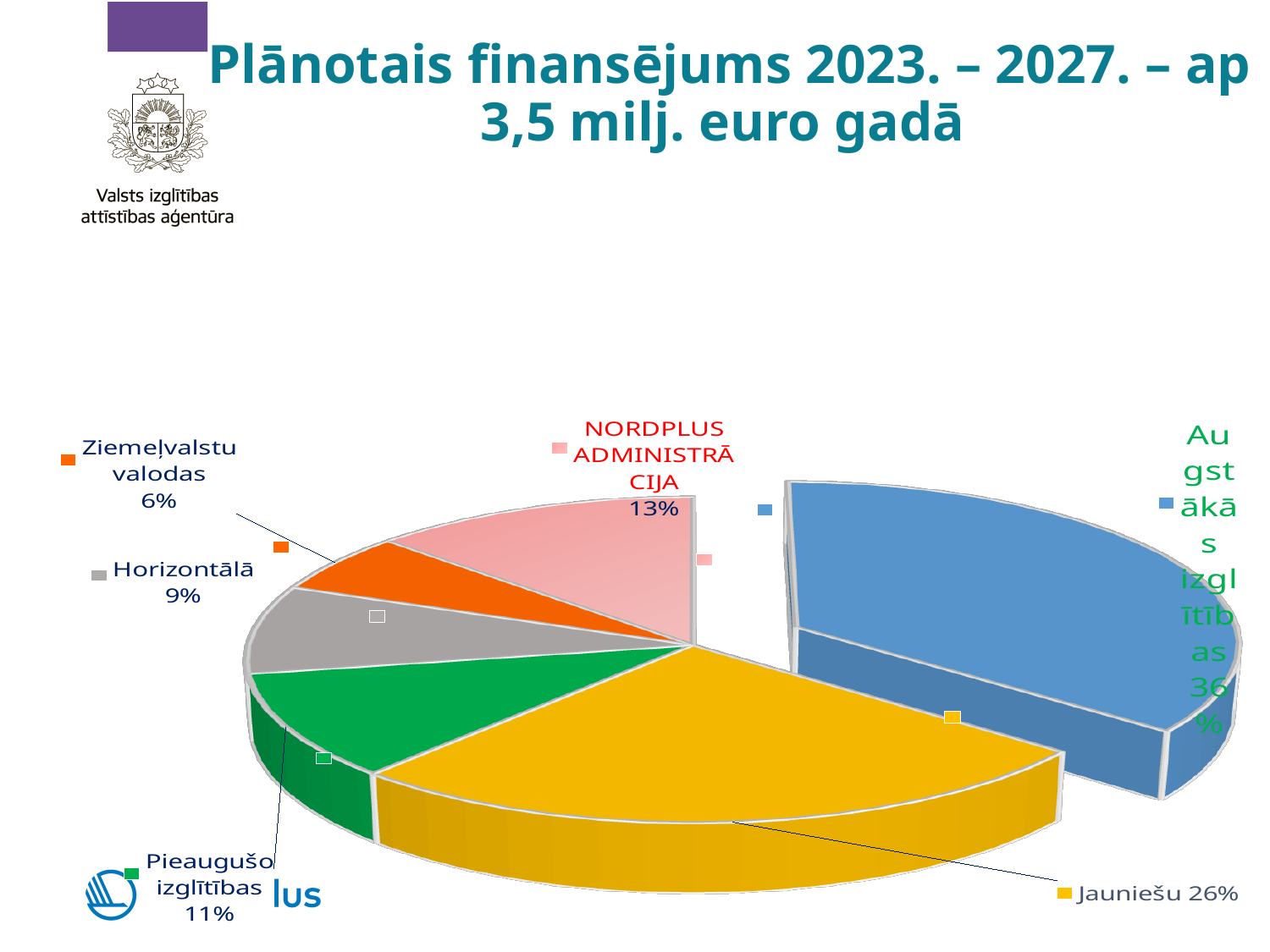
What share of the planned funding goes to Augstākās izglītības? 36% What kind of chart is shown on the slide? pie chart What percentage is shown for NORDPLUS ADMINISTRĀCIJA? 13% Which slice of the pie is the smallest? Ziemeļvalstu valodas What is the difference in percentage points between Augstākās izglītības and Jauniešu? 10 What percentage is shown for Pieaugušo izglītības? 11% What percentage is shown for Horizontālā? 9% Which slice of the pie is the largest? Augstākās izglītības Which is larger, the share for Horizontālā or the share for Pieaugušo izglītības? Pieaugušo izglītības What percentage is shown for Ziemeļvalstu valodas? 6% What share of the pie is labelled Jauniešu? 26% How many slices does the pie chart have? 6